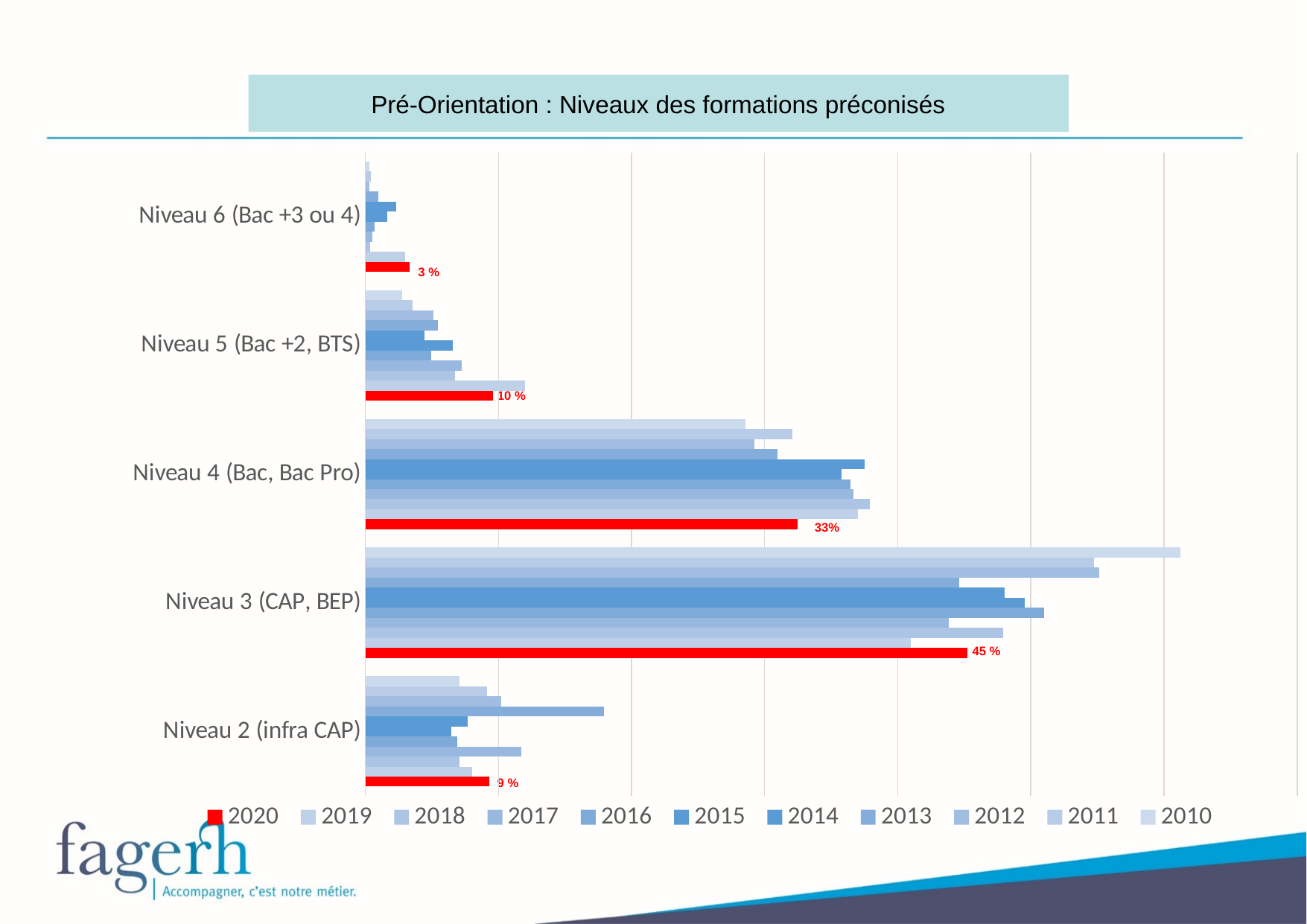
Which category has the lowest 2020 value? Niveau 6 (Bac +3 ou 4) What kind of chart is shown on the slide? Bar chart What is the 2020 value for Niveau 3 (CAP, BEP)? 45 % What is the 2020 value for Niveau 5 (Bac +2, BTS)? 10 % Which category has the highest 2020 value? Niveau 3 (CAP, BEP) What is the 2020 value for Niveau 2 (infra CAP)? 9 % How many series does the legend list? 11 What is the 2020 value for Niveau 6 (Bac +3 ou 4)? 3 % How many categories (niveaux) are shown on the chart? 5 What is the difference between the 2020 values for Niveau 3 (CAP, BEP) and Niveau 4 (Bac, Bac Pro)? 12 % What is the 2020 value for Niveau 4 (Bac, Bac Pro)? 33% In 2020, which is larger: the value for Niveau 4 (Bac, Bac Pro) or for Niveau 2 (infra CAP)? Niveau 4 (Bac, Bac Pro)